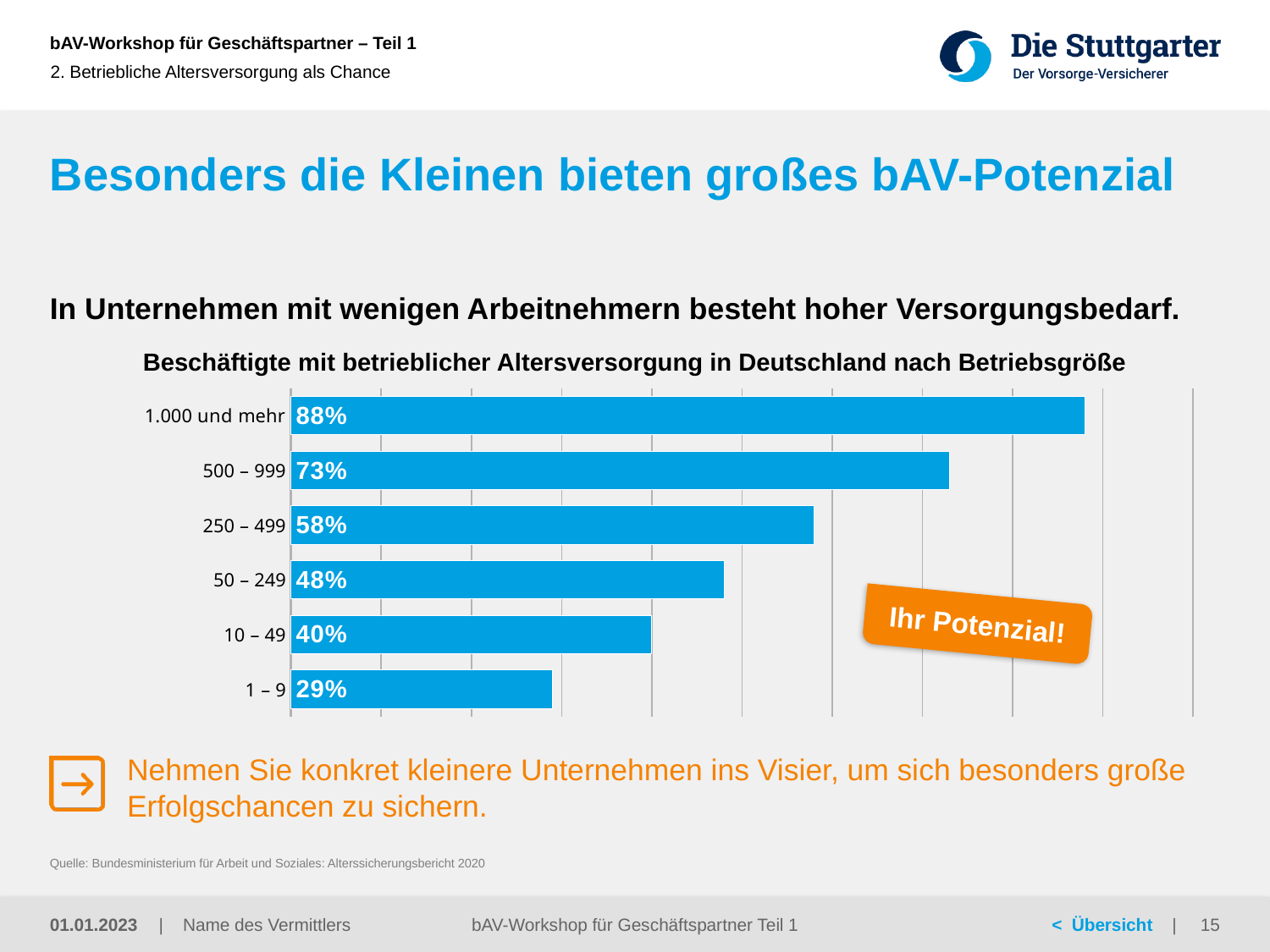
What is the difference between the values for "500 – 999" and "250 – 499"? 15% Which category has the lowest value? 1 – 9 What is the value for the category "50 – 249"? 48% How many categories does the chart show? 6 Which category has the highest value? 1.000 und mehr Do the values increase or decrease as company size increases from "1 – 9" to "1.000 und mehr"? Increase What is the title of the chart? Beschäftigte mit betrieblicher Altersversorgung in Deutschland nach Betriebsgröße Which is larger, the value for "10 – 49" or the value for "50 – 249"? 50 – 249 What kind of chart is shown on the slide? Bar chart What is the difference between the values for "1.000 und mehr" and "1 – 9"? 59% What is the value for the category "1 – 9"? 29% What is the value for the category "1.000 und mehr"? 88%